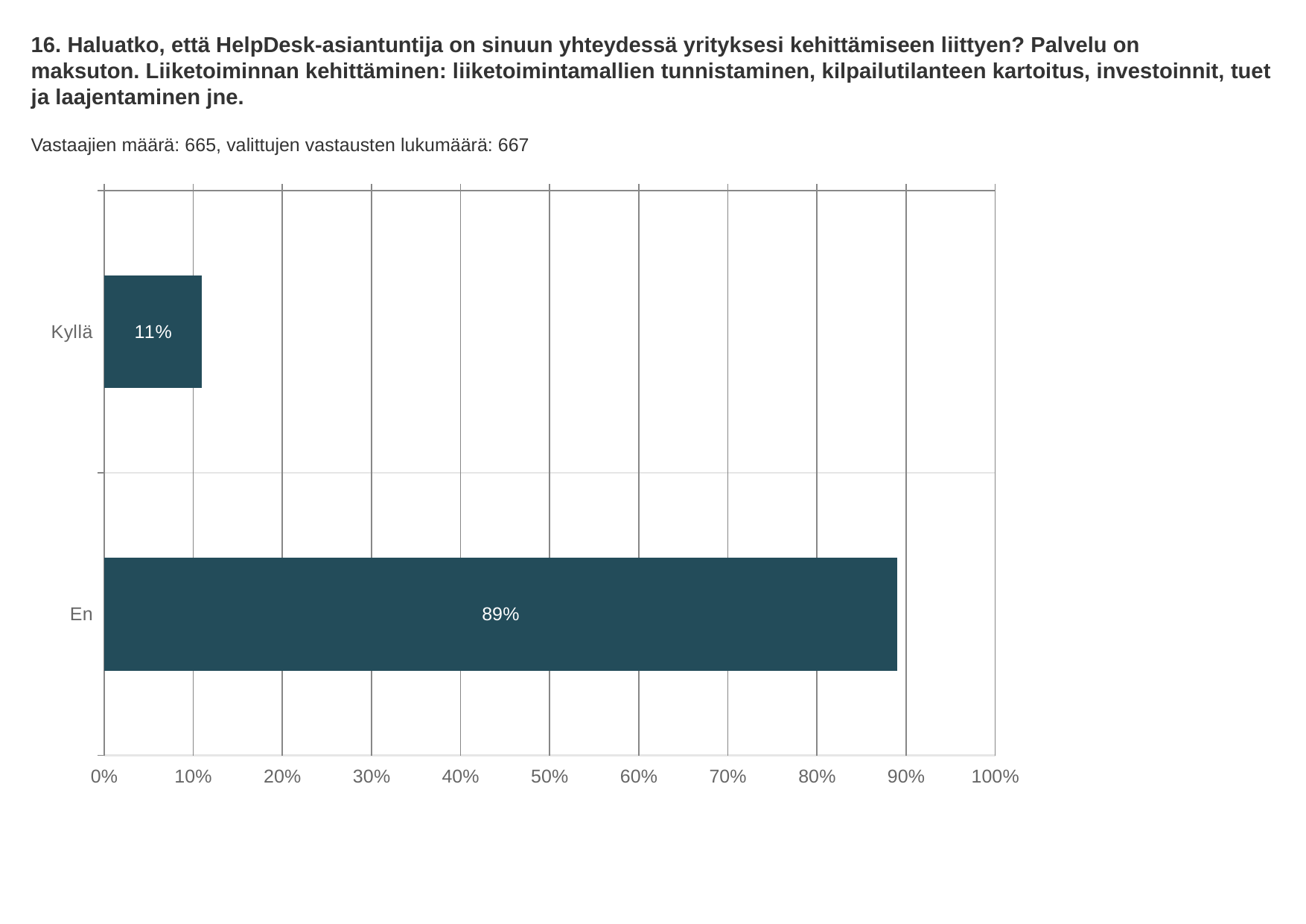
How many respondents (Vastaajien määrä) are reported on the slide? 665 What is the value for En? 89% Is the value for Kyllä greater or less than 20%? less What kind of chart is shown on the slide? bar chart What is the maximum value shown on the x axis? 100% Which category has the lowest value? Kyllä What is the difference between the values for En and Kyllä? 78% Which is larger, the value for Kyllä or the value for En? En Is the value for En greater or less than 80%? greater Which category has the highest value? En What is the value for Kyllä? 11% How many categories are shown in the chart? 2